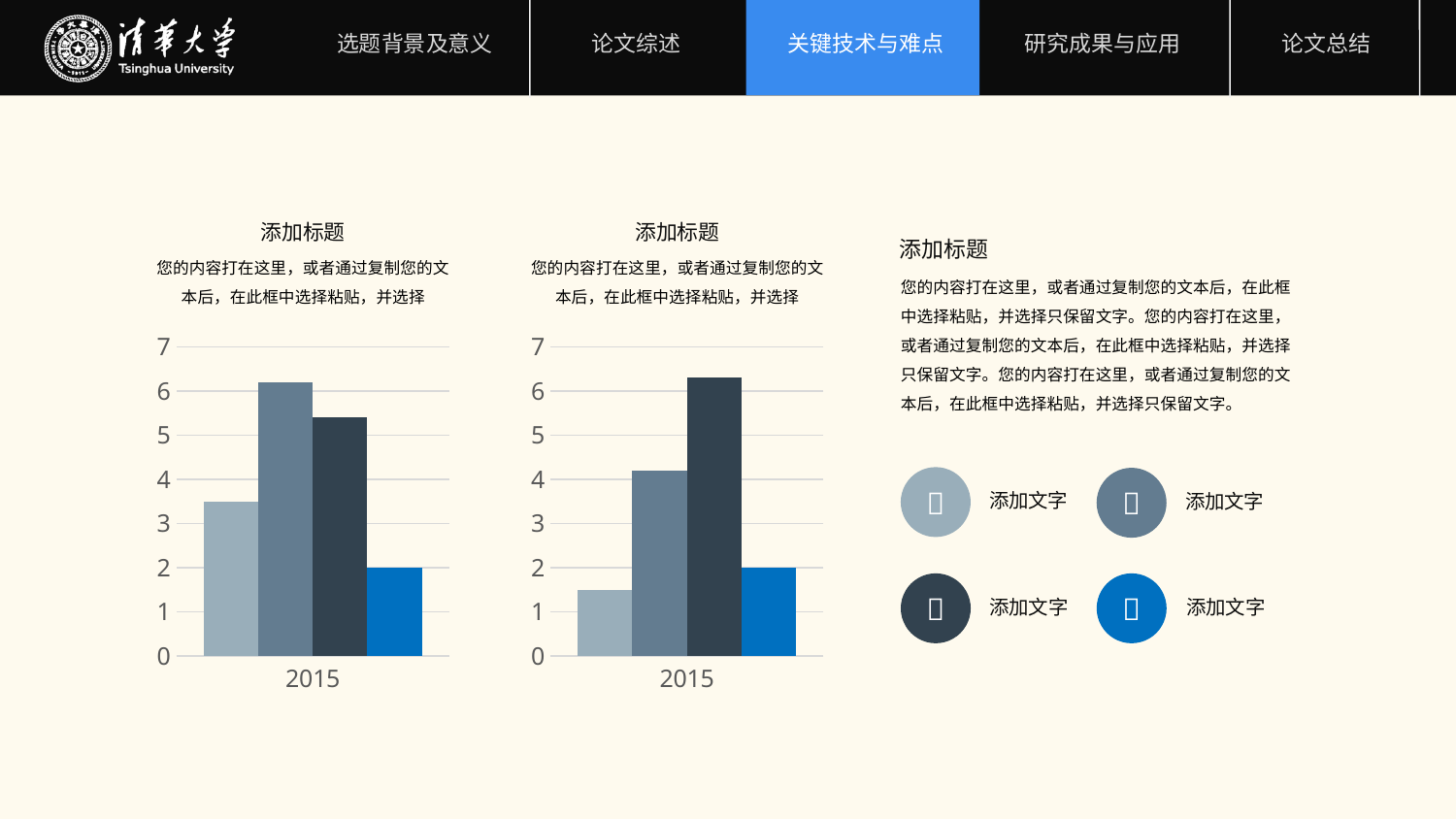
In the middle chart, is the value of the first (light grey) bar greater or less than 2? less What kind of chart is the left chart on the slide? bar chart In the middle chart, which bar is the shortest? the first (light grey) bar What is the category label on the x axis of the left chart? 2015 In the middle chart, which bar is the tallest? the third (dark navy) bar How many bars does the left chart show? 4 In the left chart, is the value of the third (dark navy) bar greater or less than 5? greater In the left chart, which bar is the shortest? the fourth (blue) bar In the middle chart, is the value of the second (grey-blue) bar greater or less than 4? greater In the left chart, which bar is the tallest? the second (grey-blue) bar In the middle chart, which is larger: the dark navy bar or the blue bar? the dark navy bar